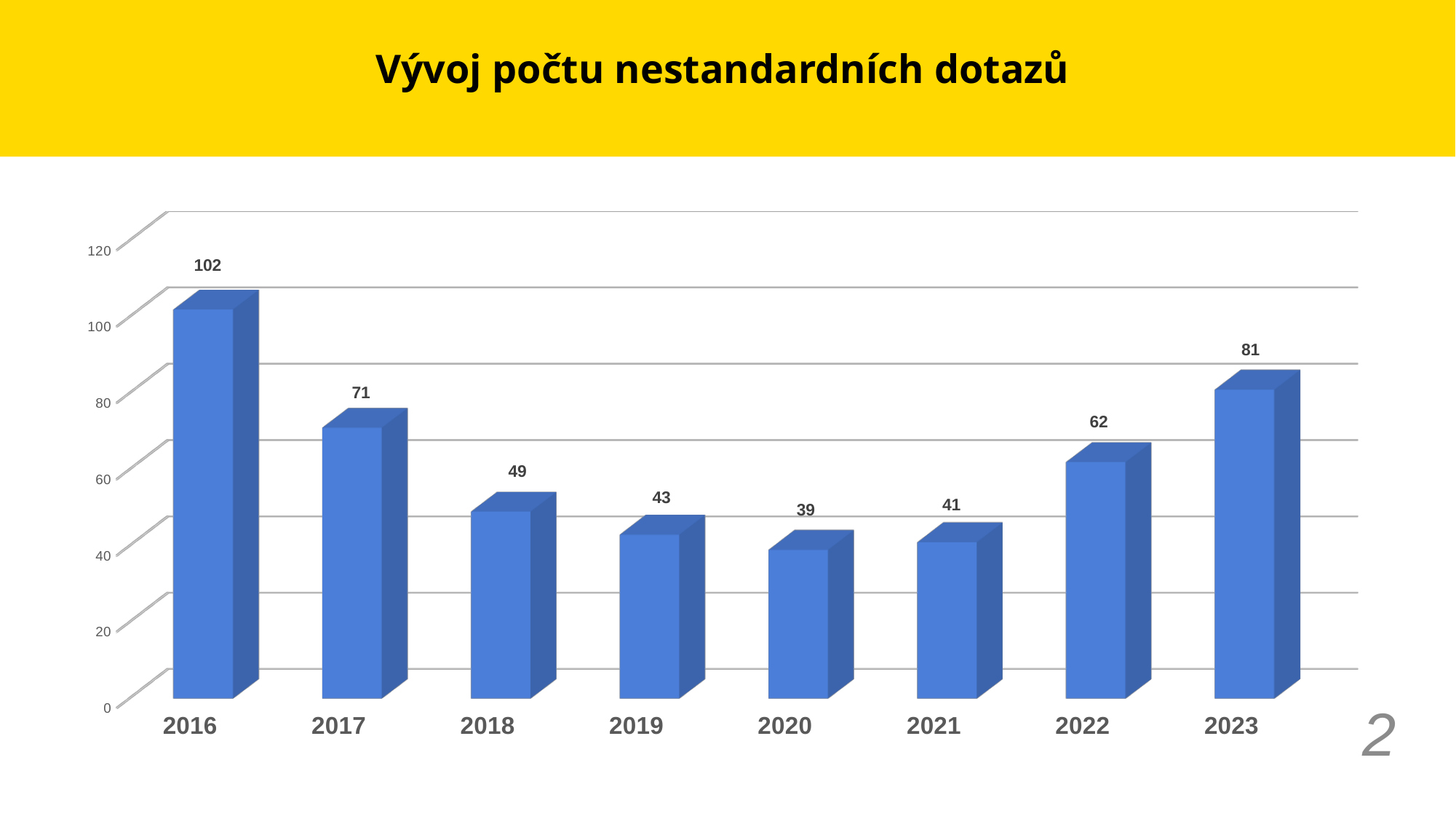
What is the difference between the values for 2016 and 2017? 31 Which year has the highest value? 2016 Which is larger, the value for 2018 or the value for 2019? 2018 What is the difference between the values for 2023 and 2022? 19 Is the value for 2022 greater or less than 60? greater What is the title of the chart? Vývoj počtu nestandardních dotazů What is the value for 2023? 81 How many years are shown on the x axis? 8 What is the value for 2016? 102 What is the value for 2020? 39 Which year has the lowest value? 2020 What kind of chart is shown on the slide? bar chart